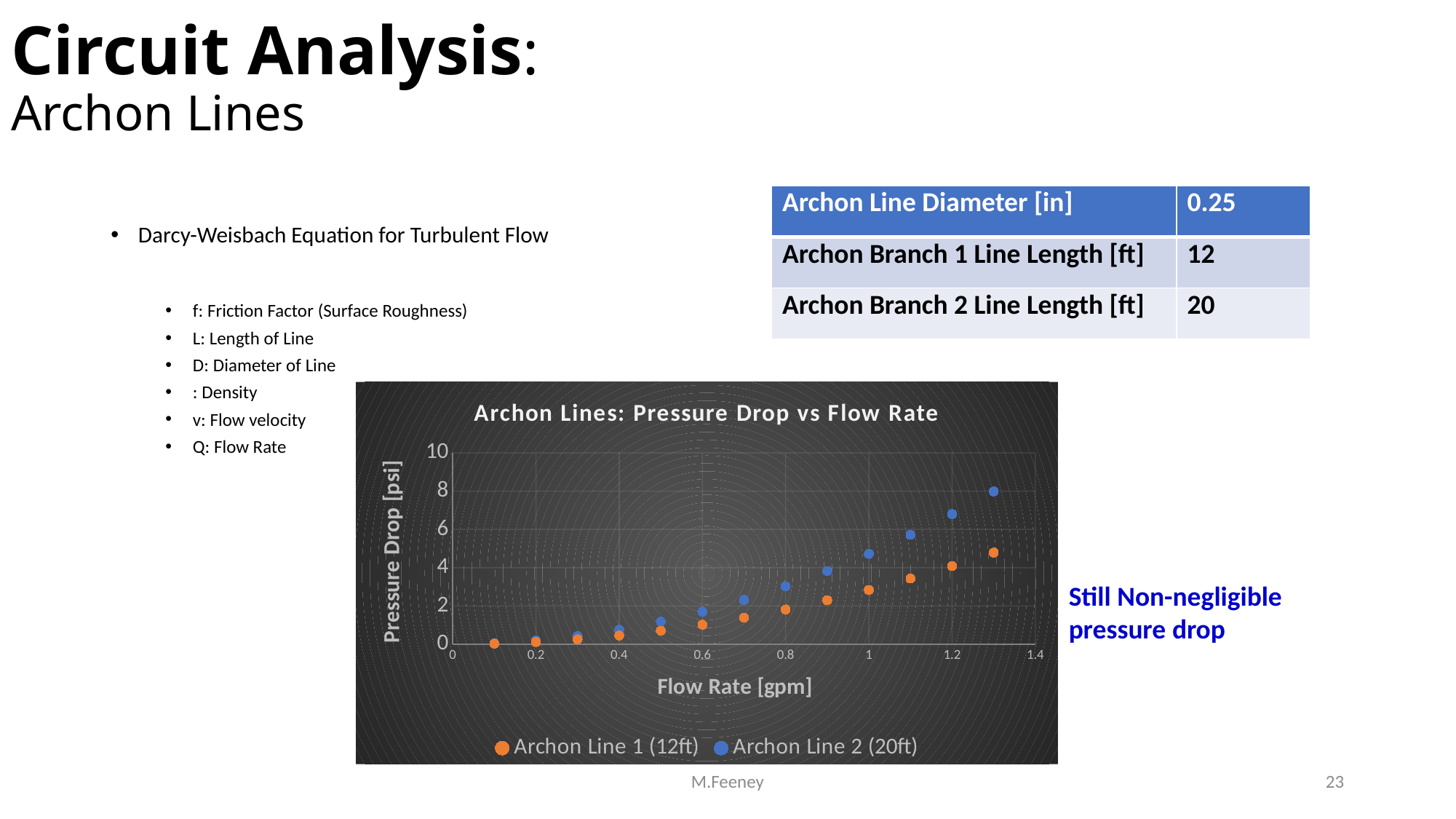
How many series does the chart legend list? 2 What is the title of the chart? Archon Lines: Pressure Drop vs Flow Rate Is the pressure drop for Archon Line 1 (12ft) at 1.3 gpm greater or less than 6 psi? less What kind of chart is shown on the slide? Scatter chart How many data points are plotted for the Archon Line 2 (20ft) series? 13 Is the pressure drop for Archon Line 1 (12ft) at 0.5 gpm greater or less than 2 psi? less Does the pressure drop rise or fall as flow rate increases along the x axis? Rise Is the pressure drop for Archon Line 2 (20ft) at 1.0 gpm greater or less than 4 psi? greater What is the label of the y axis of the chart? Pressure Drop [psi] At a flow rate of 1.3 gpm, which series has the higher pressure drop, Archon Line 1 (12ft) or Archon Line 2 (20ft)? Archon Line 2 (20ft)